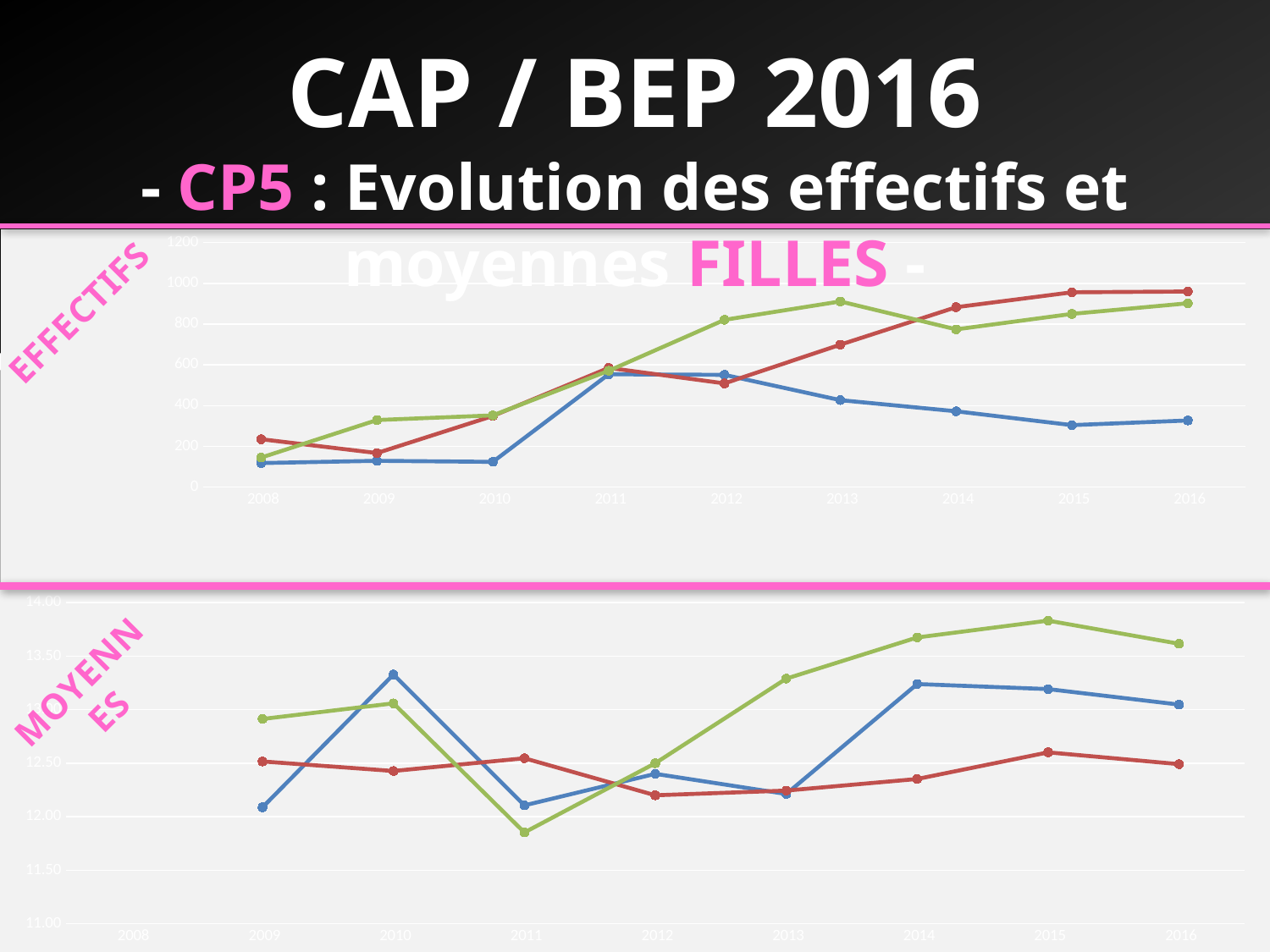
In the bottom chart (MOYENNES), in which year is the green line at its highest? 2015 In the bottom chart (MOYENNES), in which year is the green line at its lowest? 2011 In the bottom chart (MOYENNES), is the value of the green line in 2015 greater or less than 13.50? greater What kind of chart is the bottom chart labelled MOYENNES? line chart In the top chart (EFFECTIFS), in which year is the green line at its lowest? 2008 How many lines are plotted in the bottom chart (MOYENNES)? 3 In the top chart (EFFECTIFS), which line is higher in 2016, the red line or the blue line? red line In the top chart (EFFECTIFS), how many years are labelled on the x axis? 9 In the top chart (EFFECTIFS), is the value of the blue line in 2016 greater or less than 400? less In the top chart (EFFECTIFS), is the value of the red line in 2016 greater or less than 800? greater What kind of chart is the top chart labelled EFFECTIFS? line chart In the top chart (EFFECTIFS), does the red line overall rise or fall from 2008 to 2016? rise